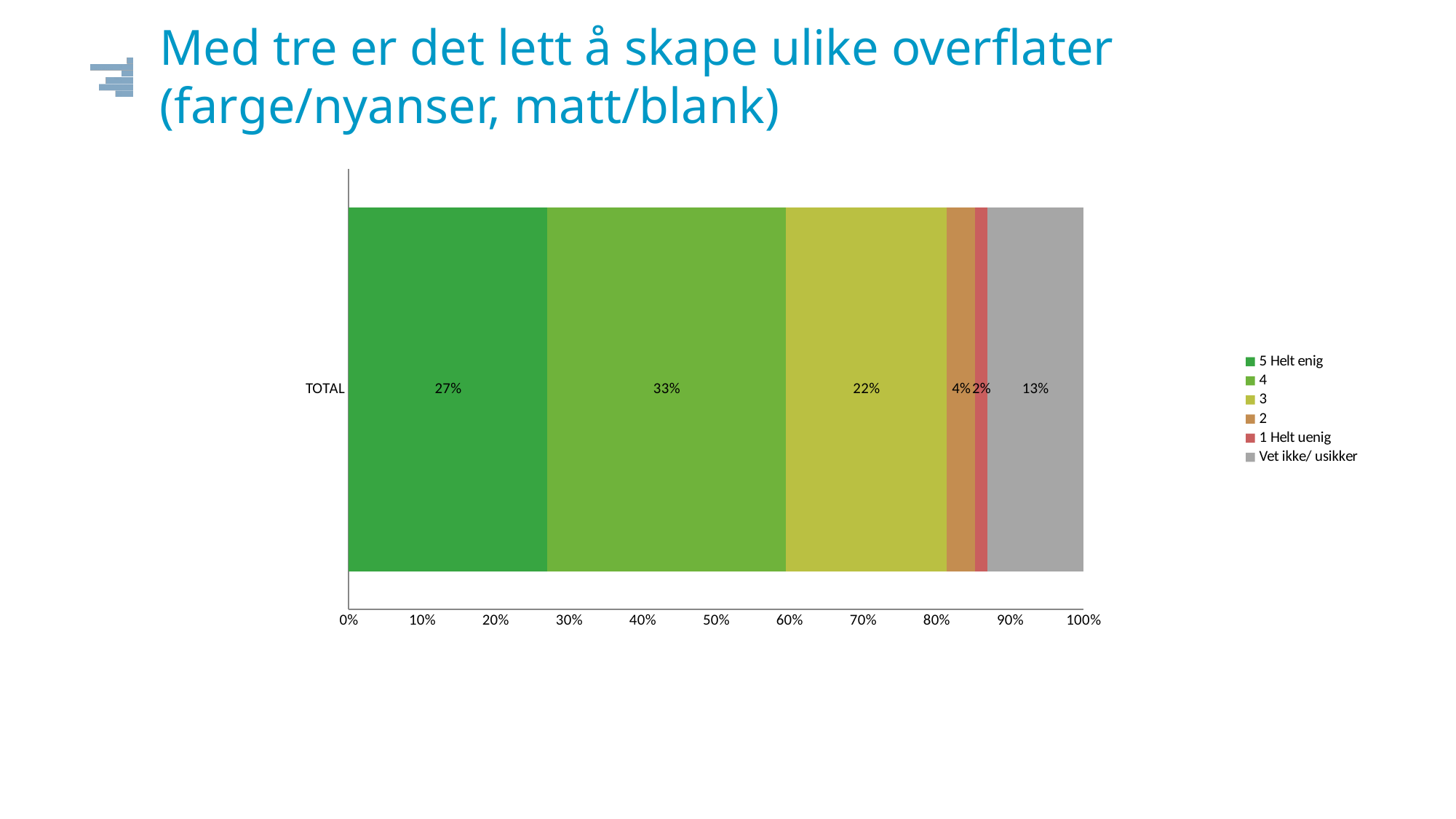
How many series does the legend list? 6 What share of the TOTAL bar is 'Vet ikke/ usikker'? 13% Which response category has the largest share of the TOTAL bar? 4 What is the difference between the '4' segment and the '3' segment? 11% What is the combined share of '5 Helt enig' and '4'? 60% What is the value for the '4' segment of the TOTAL bar? 33% What is the value for '1 Helt uenig'? 2% Which response category has the smallest share of the TOTAL bar? 1 Helt uenig What kind of chart is shown on the slide? Stacked bar chart Which is larger, the '5 Helt enig' segment or the 'Vet ikke/ usikker' segment? 5 Helt enig What percentage of respondents answered '5 Helt enig'? 27% What colour is the 'Vet ikke/ usikker' segment? Grey